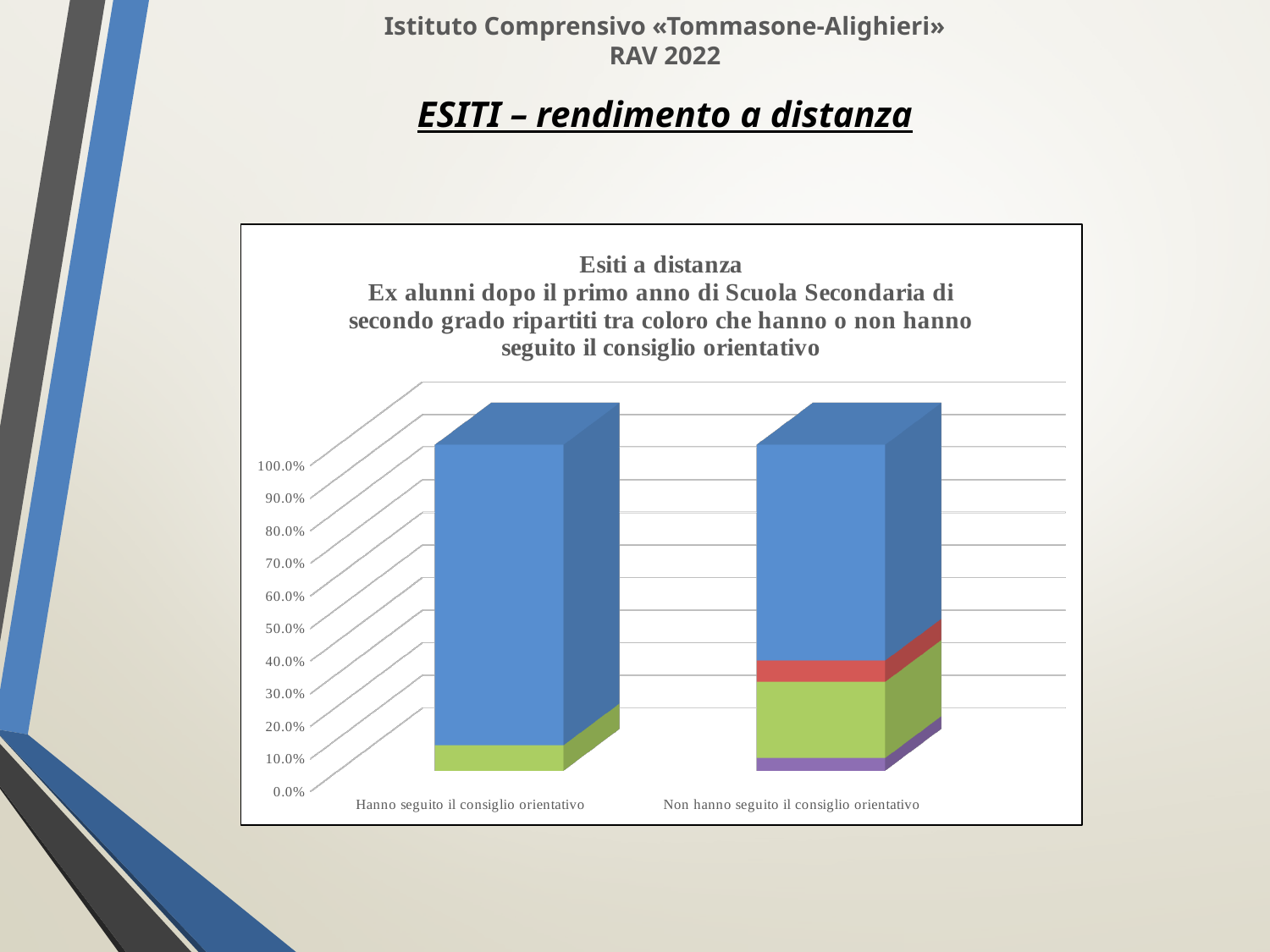
Which bar has the larger green segment, 'Hanno seguito il consiglio orientativo' or 'Non hanno seguito il consiglio orientativo'? Non hanno seguito il consiglio orientativo Is the green segment of the bar for 'Non hanno seguito il consiglio orientativo' greater or less than 10%? greater How many coloured segments make up the bar for 'Non hanno seguito il consiglio orientativo'? 4 Is the blue segment of the bar for 'Non hanno seguito il consiglio orientativo' greater or less than 50%? greater How many categories are shown on the x axis of the chart? 2 What kind of chart is shown on the slide? Stacked bar chart How many coloured segments make up the bar for 'Hanno seguito il consiglio orientativo'? 2 Is the green segment of the bar for 'Hanno seguito il consiglio orientativo' greater or less than 10%? less What is the lowest value shown on the chart's y axis? 0.0% What is the highest value shown on the chart's y axis? 100.0% What is the first line of the chart's title? Esiti a distanza What is the label of the left-hand bar on the chart? Hanno seguito il consiglio orientativo